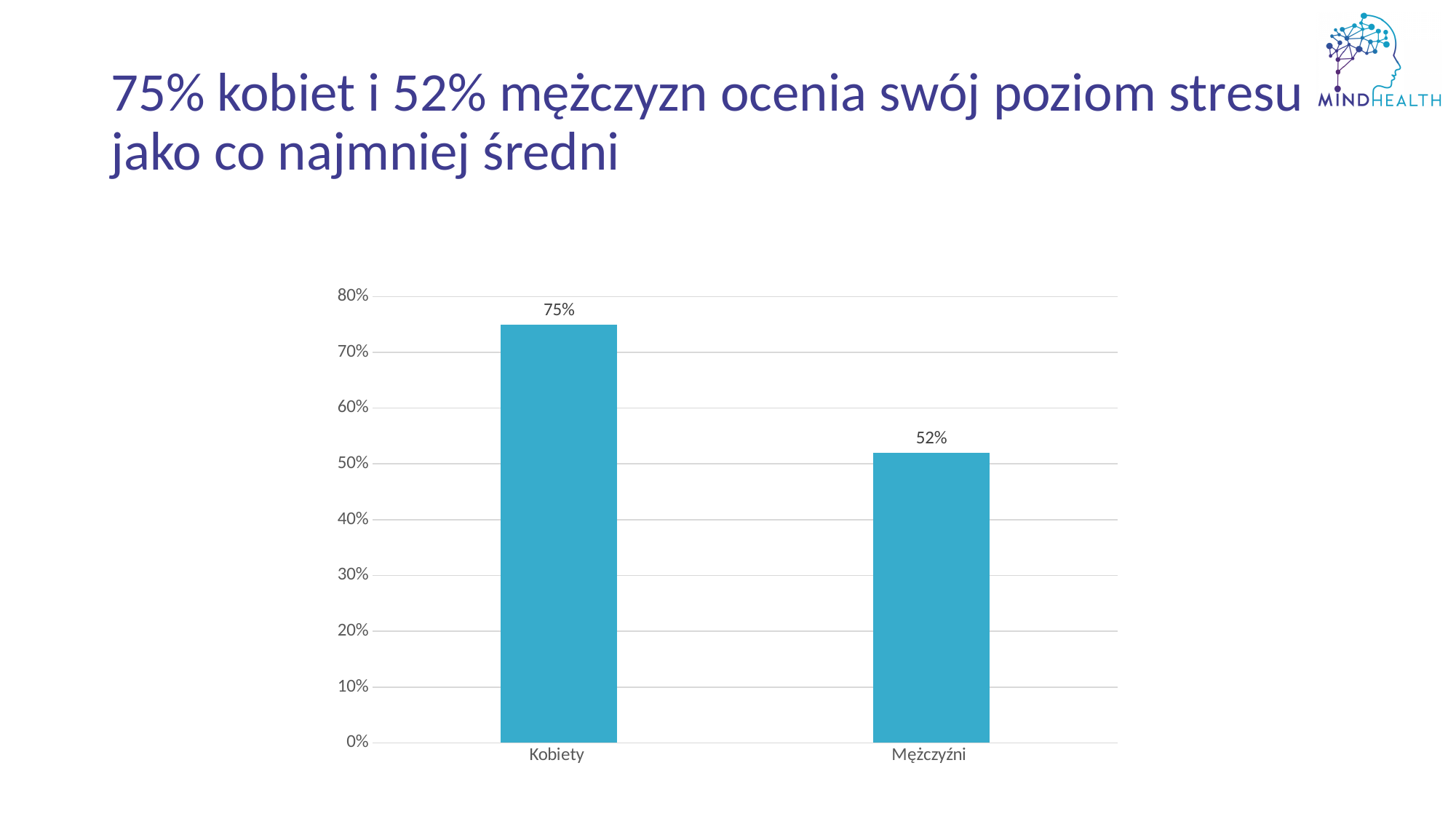
How many categories are shown on the x axis? 2 Which category has the lowest value? Mężczyźni Which category has the highest value? Kobiety Is the value for Kobiety greater or less than 70%? greater What is the highest value shown on the y axis? 80% What colour are the bars in the chart? blue What kind of chart is shown on the slide? bar chart Which is larger, the value for Kobiety or the value for Mężczyźni? Kobiety What is the value for Kobiety? 75% What is the difference between the values for Kobiety and Mężczyźni? 23% What is the value for Mężczyźni? 52% Is the value for Mężczyźni greater or less than 60%? less